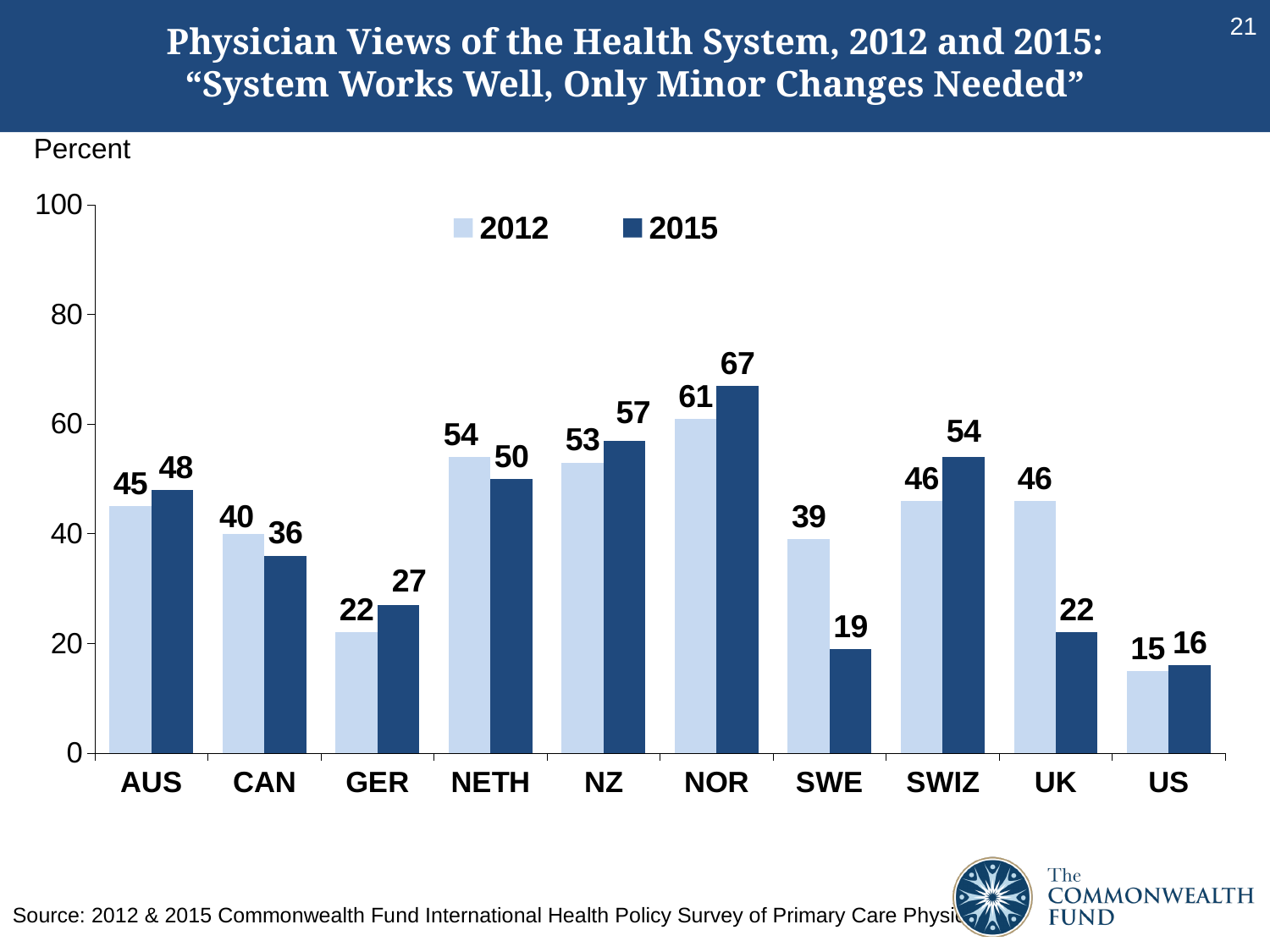
How many series does the legend list? 2 What is the 2015 value for UK? 22 What is the 2012 value for SWE? 39 What is the 2015 value for NOR? 67 Is the 2012 value for NETH greater or less than 40? greater Which country has the highest 2015 value? NOR How many countries are shown on the x axis? 10 What is the difference between the 2012 and 2015 values for SWE? 20 Which is larger for CAN, the 2012 value or the 2015 value? 2012 Which country has the lowest 2012 value? US What kind of chart is shown on the slide? bar chart What is the difference between the 2015 values for NOR and GER? 40